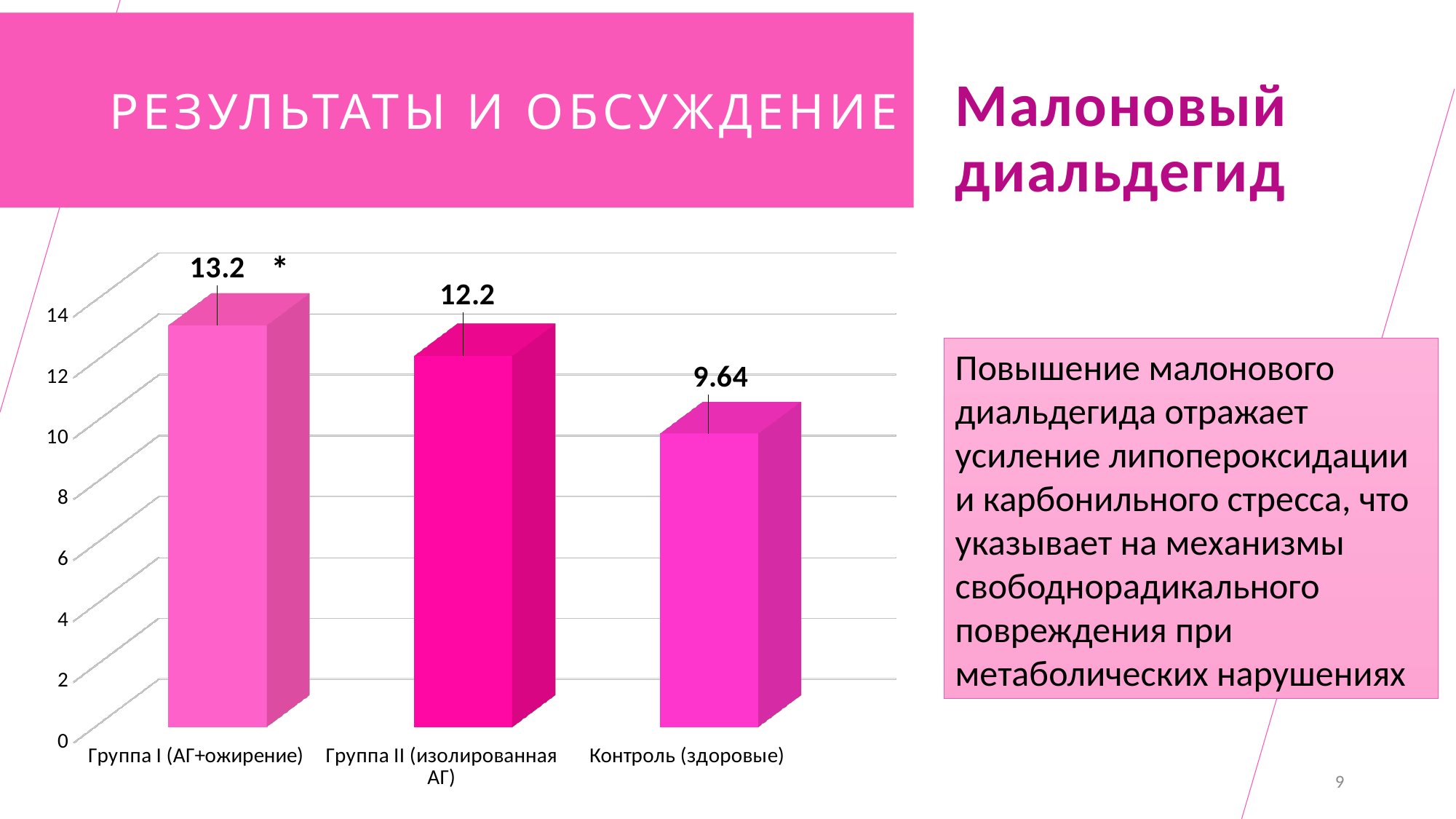
What is the value for Группа I (АГ+ожирение)? 13.2 What is the difference between the values for Группа I (АГ+ожирение) and Группа II (изолированная АГ)? 1 What kind of chart is shown on the slide? bar chart Which category has the highest value? Группа I (АГ+ожирение) What is the value for Контроль (здоровые)? 9.64 Is the value for Контроль (здоровые) greater or less than 10? less What is the value for Группа II (изолированная АГ)? 12.2 Do the values rise or fall from left to right across the categories? fall What is the difference between the values for Группа I (АГ+ожирение) and Контроль (здоровые)? 3.56 How many categories are shown in the chart? 3 Which is larger, the value for Группа II (изолированная АГ) or Контроль (здоровые)? Группа II (изолированная АГ) Which category has the lowest value? Контроль (здоровые)